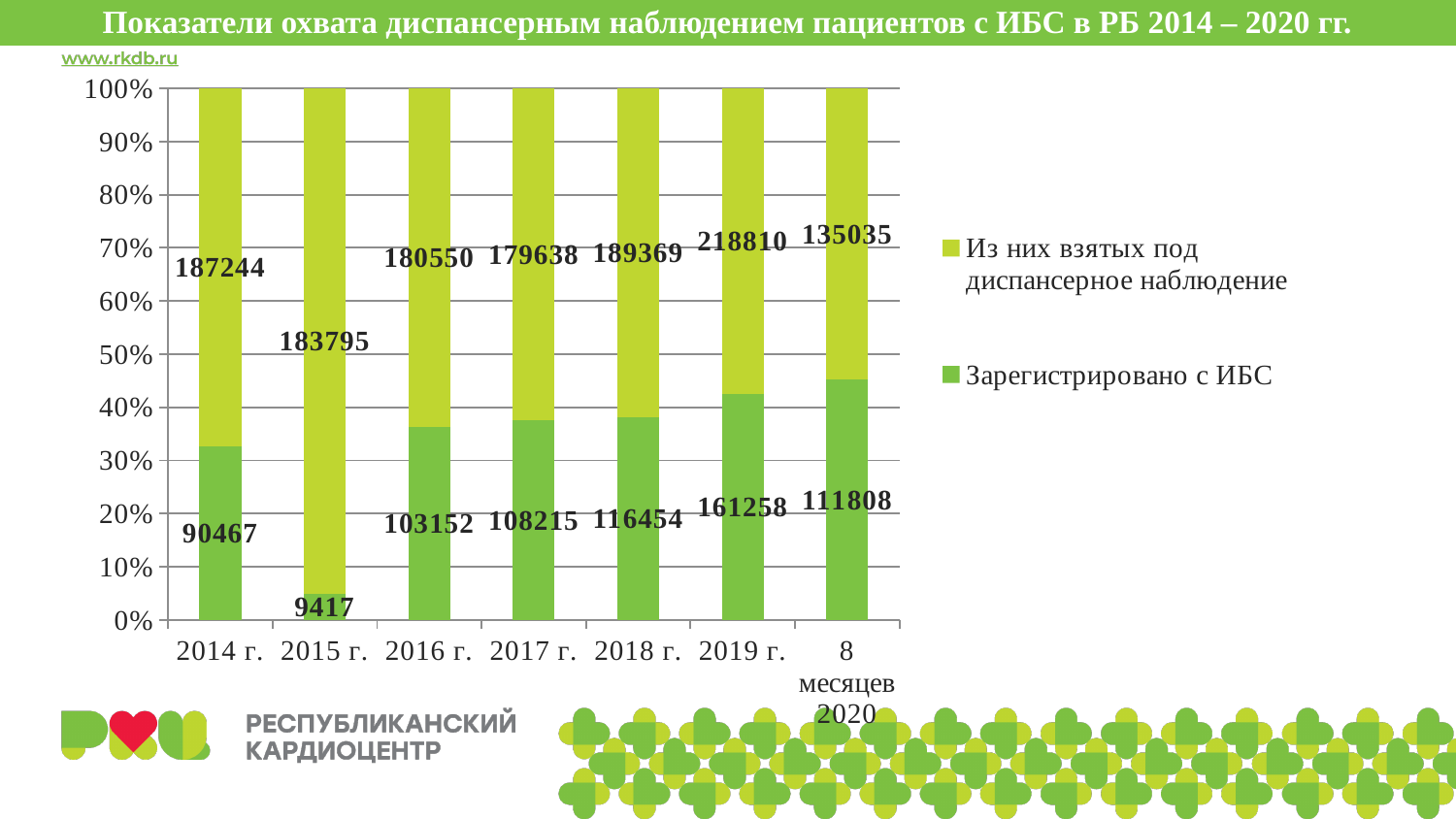
What value is shown for 'Зарегистрировано с ИБС' in 2014 г.? 90467 Which is larger: the 'Зарегистрировано с ИБС' value in 2018 г. or in 2019 г.? 2019 г. What kind of chart is shown on the slide? stacked bar chart In which year is the value for 'Зарегистрировано с ИБС' the lowest? 2015 г. What value is shown for 'Из них взятых под диспансерное наблюдение' in 2019 г.? 218810 What is the difference between the two series values in 2014 г. (187244 and 90467)? 96777 Is the share of the dark green segment ('Зарегистрировано с ИБС') in 2015 г. greater or less than 10%? less In which year is the value for 'Зарегистрировано с ИБС' the highest? 2019 г. What value is shown for 'Из них взятых под диспансерное наблюдение' for 8 месяцев 2020? 135035 What value is shown for 'Зарегистрировано с ИБС' in 2015 г.? 9417 How many categories are shown on the x axis? 7 How many series does the legend list? 2